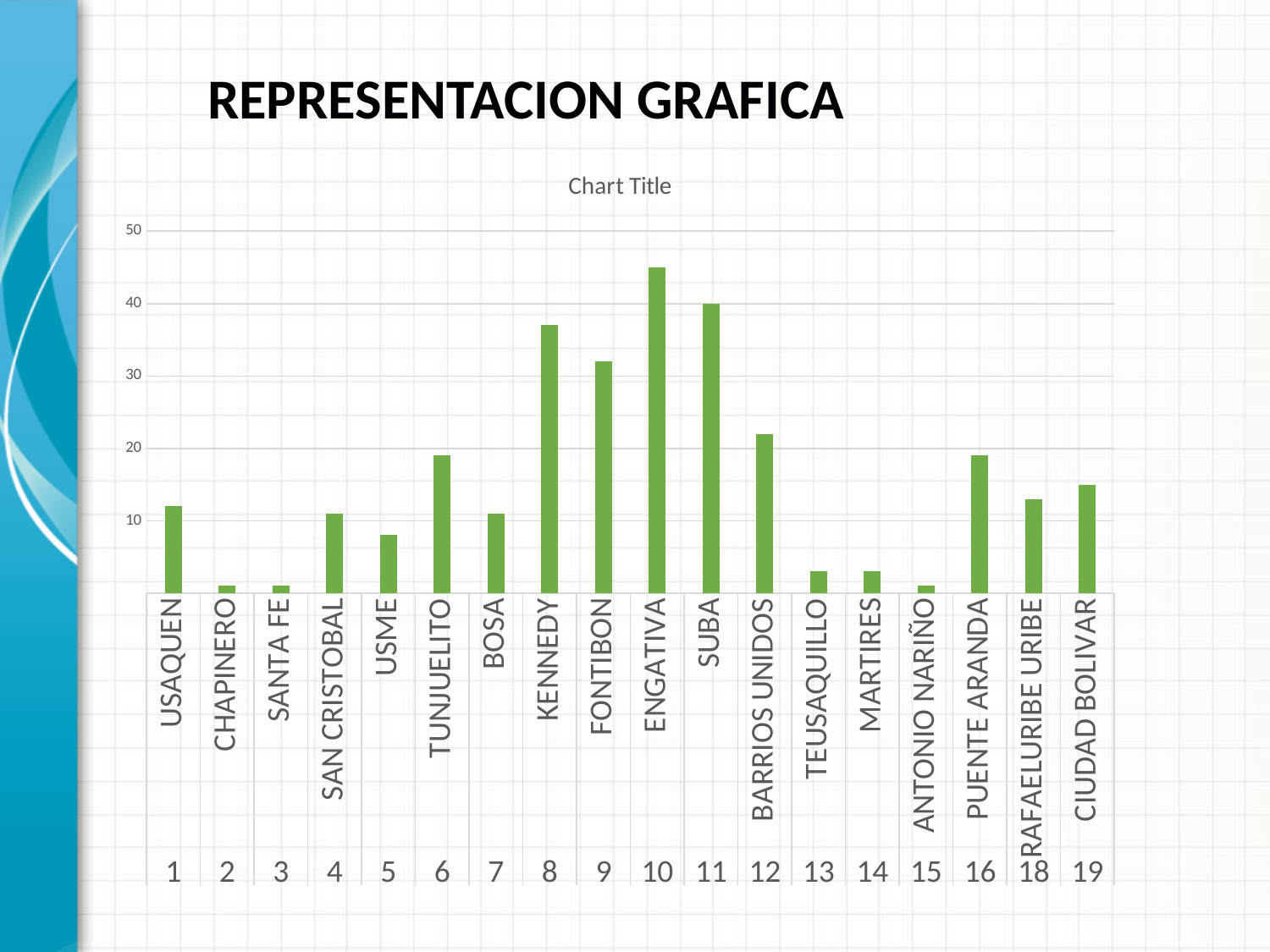
Is the value for KENNEDY greater or less than 30? greater Which is larger, the value for ENGATIVA or the value for SUBA? ENGATIVA How many categories (bars) are plotted in the chart? 18 What is the title shown above the chart? Chart Title What kind of chart is shown on the slide? bar chart Is the value for ENGATIVA greater or less than 40? greater Is the value for USME greater or less than 10? less Which category has the highest value? ENGATIVA Which is larger, the value for CIUDAD BOLIVAR or the value for TEUSAQUILLO? CIUDAD BOLIVAR Which is larger, the value for KENNEDY or the value for FONTIBON? KENNEDY